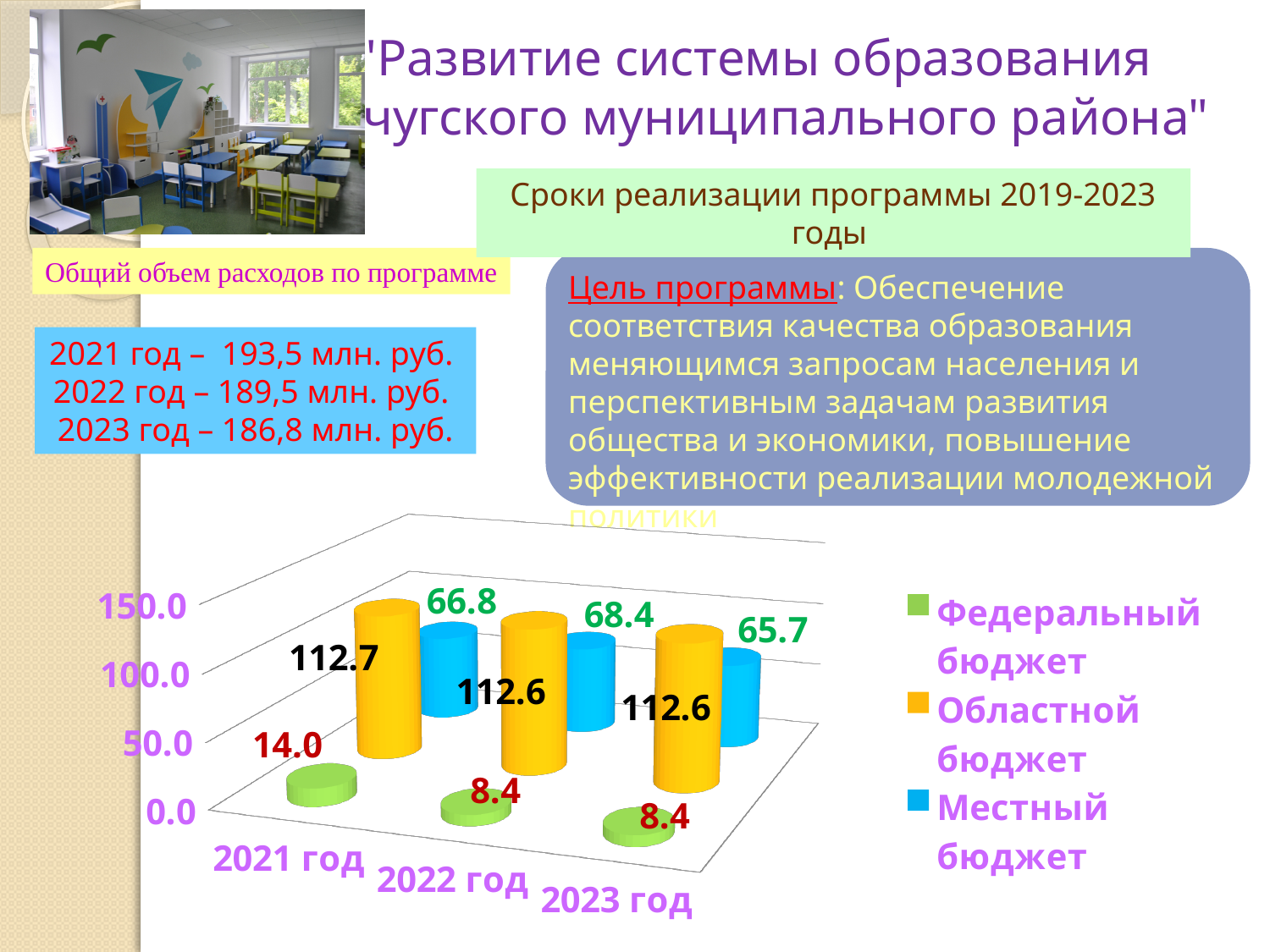
Which year has the highest value for Федеральный бюджет? 2021 год What is the value for Областной бюджет in 2021 год? 112.7 What kind of chart is shown on the slide? Bar chart Which year has the lowest value for Местный бюджет? 2023 год What is the value for Федеральный бюджет in 2023 год? 8.4 What is the value for Федеральный бюджет in 2021 год? 14.0 What is the value for Местный бюджет in 2022 год? 68.4 What is the difference between the Местный бюджет values for 2022 год and 2023 год? 2.7 Which is larger in 2021 год: Областной бюджет or Местный бюджет? Областной бюджет What is the value for Местный бюджет in 2023 год? 65.7 What is the difference between the Федеральный бюджет values for 2021 год and 2022 год? 5.6 How many series does the legend list? 3